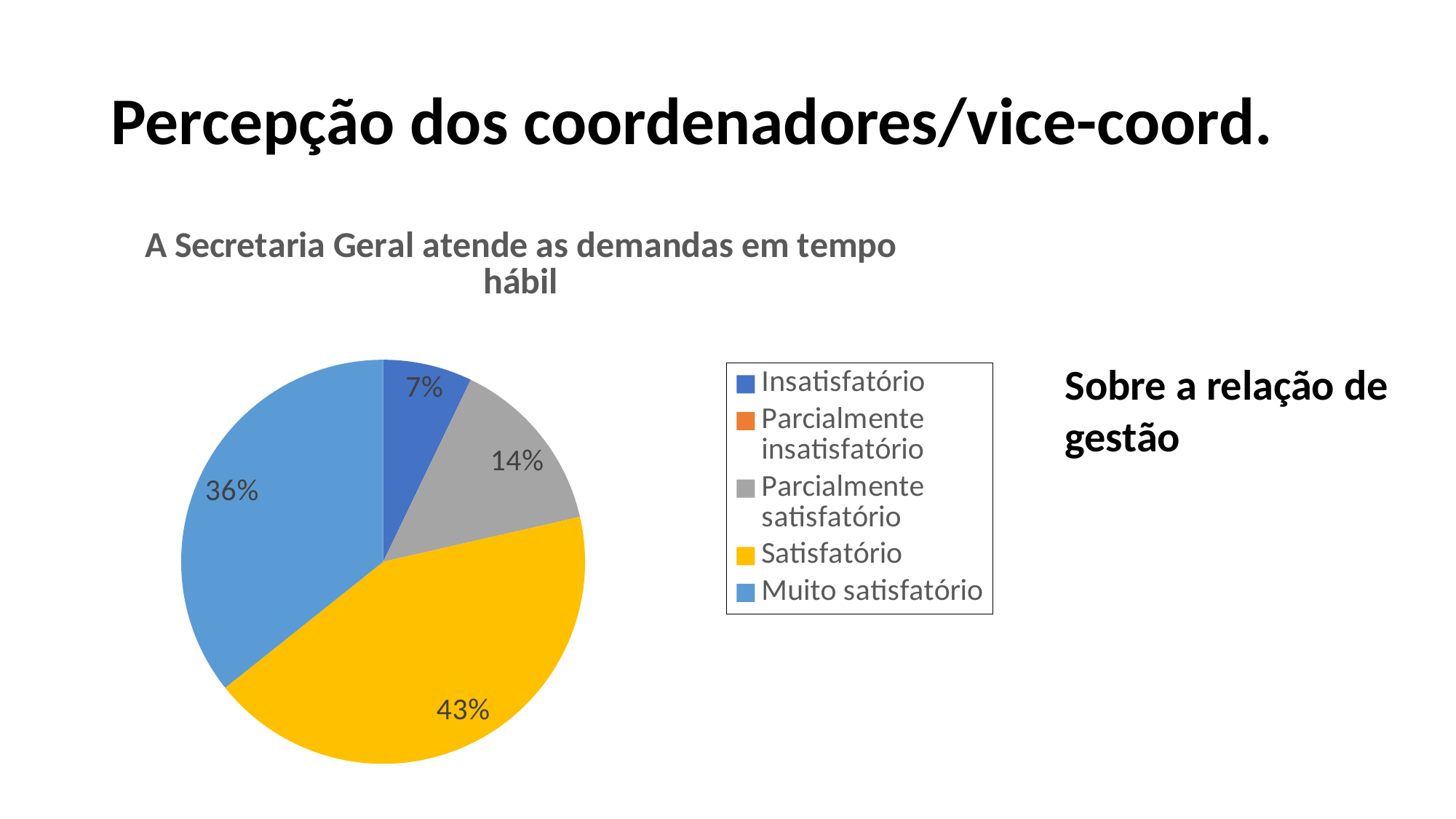
What is the title of the chart? A Secretaria Geral atende as demandas em tempo hábil What percentage of the pie is labelled Satisfatório? 43% Which category has the largest slice of the pie? Satisfatório What percentage of the pie is labelled Parcialmente satisfatório? 14% Which slice is larger, Parcialmente satisfatório or Muito satisfatório? Muito satisfatório How many percentage points larger is the Satisfatório slice than the Muito satisfatório slice? 7 What percentage of the pie is labelled Insatisfatório? 7% What type of chart is shown on the slide? Pie chart How many entries does the legend list? 5 What percentage of the pie is labelled Muito satisfatório? 36% Which of the labelled slices is the smallest? Insatisfatório What colour is the Satisfatório slice? Yellow